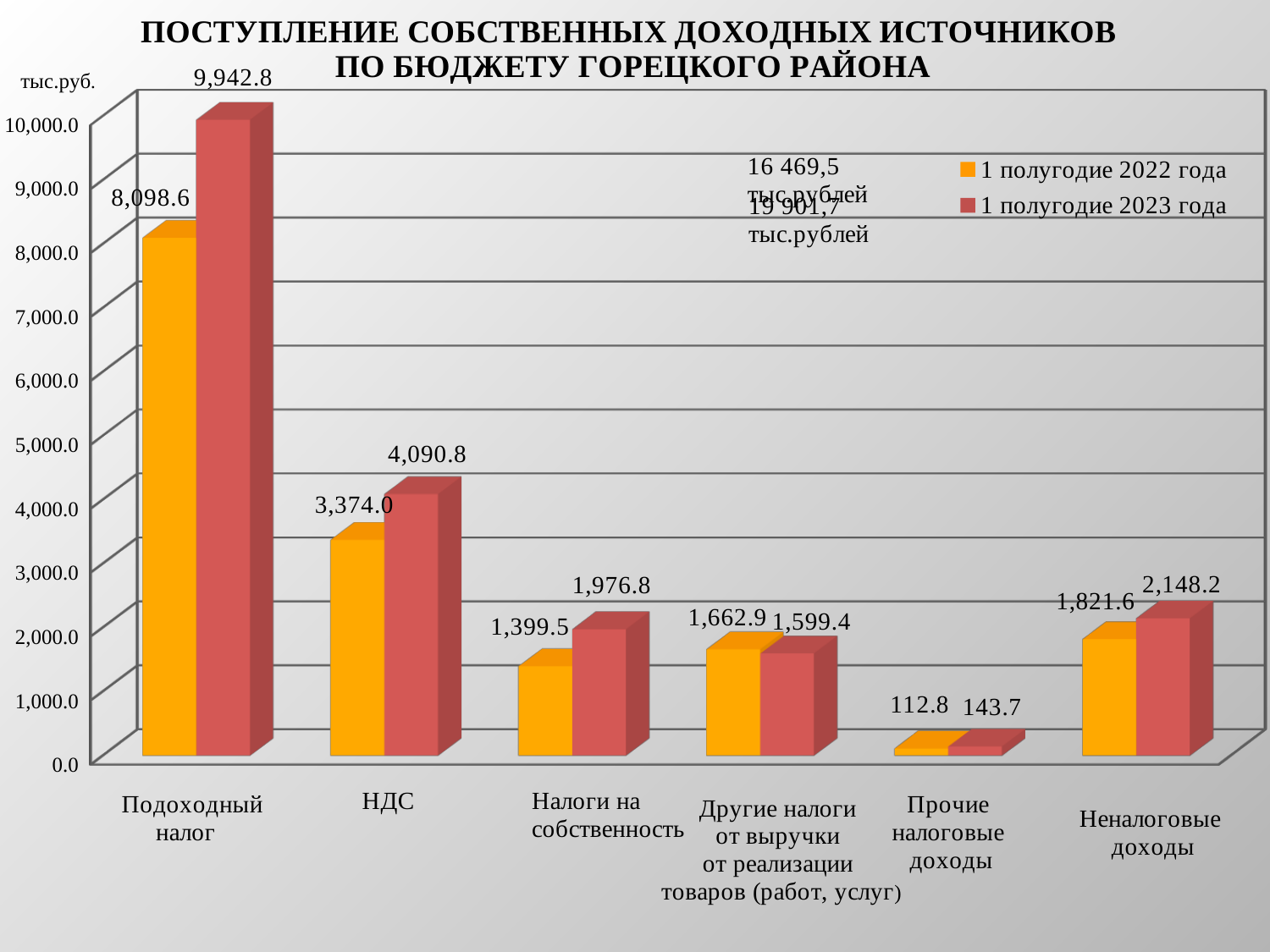
For Другие налоги от выручки от реализации товаров (работ, услуг), which is larger: the 1 полугодие 2022 года value or the 1 полугодие 2023 года value? 1 полугодие 2022 года How many series does the legend list? 2 What is the value for Неналоговые доходы in 1 полугодие 2023 года? 2,148.2 Which category has the highest value in 1 полугодие 2022 года? Подоходный налог What kind of chart is shown on the slide? bar chart What is the value for Подоходный налог in 1 полугодие 2023 года? 9,942.8 What is the value for НДС in 1 полугодие 2022 года? 3,374.0 What is the difference between the 1 полугодие 2023 года and 1 полугодие 2022 года values for Подоходный налог? 1,844.2 Which category has the lowest value in 1 полугодие 2023 года? Прочие налоговые доходы What is the value for Прочие налоговые доходы in 1 полугодие 2022 года? 112.8 How many categories are shown on the x axis? 6 Is the value for Налоги на собственность in 1 полугодие 2023 года greater or less than 2,000.0? less